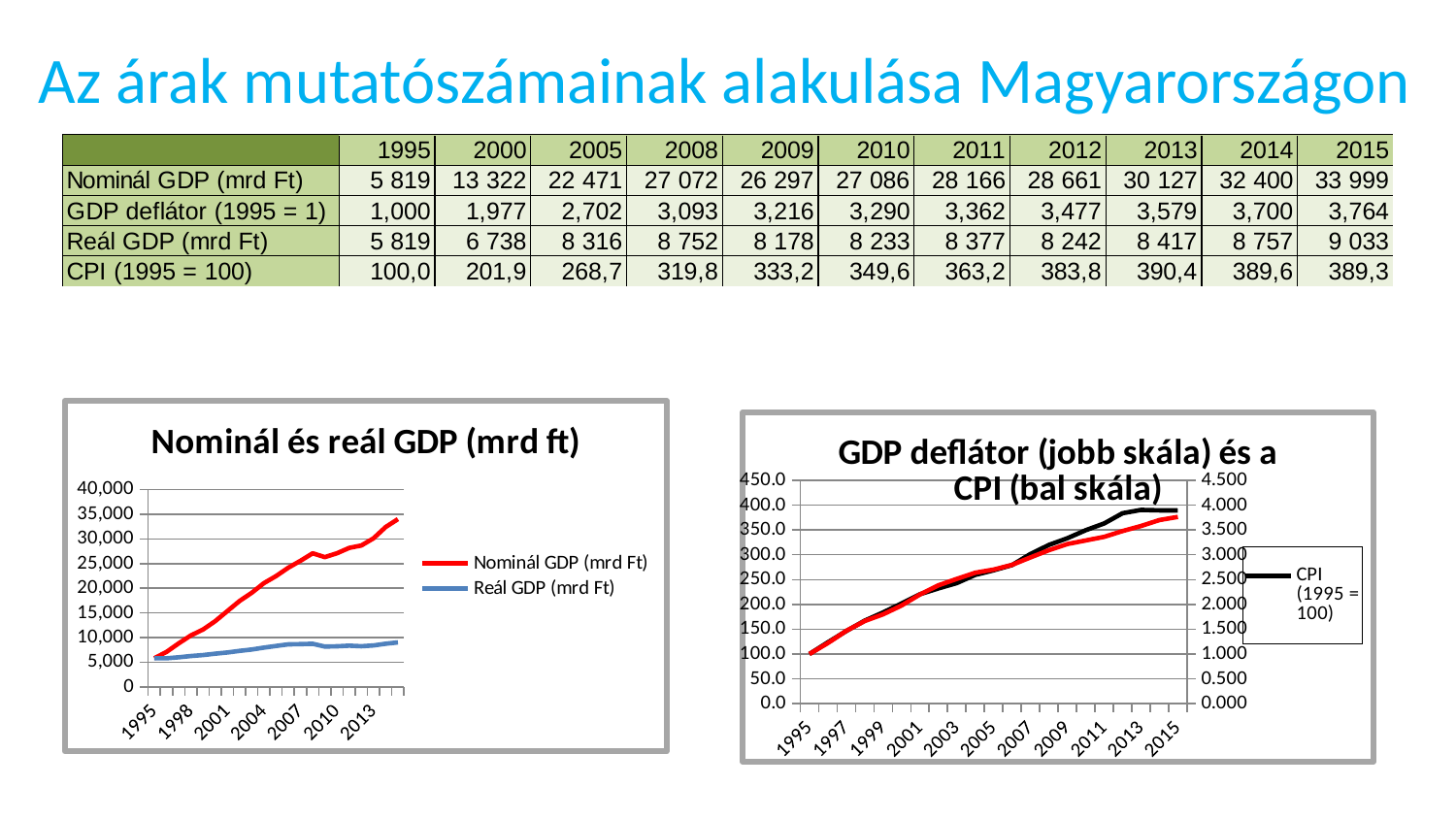
In the left chart "Nominál és reál GDP (mrd ft)", is the Reál GDP value at the end of the series (2015) greater or less than 10,000? less In the right chart "GDP deflátor (jobb skála) és a CPI (bal skála)", does the CPI line rise or fall overall from 1995 to 2015? rise In the right chart "GDP deflátor (jobb skála) és a CPI (bal skála)", is the CPI value in 2015 greater or less than 350.0 on the left scale? greater In the left chart "Nominál és reál GDP (mrd ft)", does the Nominál GDP line rise or fall from 1995 to 2015? rise How many series does the legend of the left chart "Nominál és reál GDP (mrd ft)" list? 2 In the left chart "Nominál és reál GDP (mrd ft)", which series is drawn in red? Nominál GDP (mrd Ft) In the left chart "Nominál és reál GDP (mrd ft)", is the Nominál GDP value at the end of the series (2015) greater or less than 30,000? greater What kind of chart is the right chart titled "GDP deflátor (jobb skála) és a CPI (bal skála)"? line chart What kind of chart is the left chart titled "Nominál és reál GDP (mrd ft)"? line chart How many year labels are shown on the x axis of the right chart "GDP deflátor (jobb skála) és a CPI (bal skála)"? 11 In the left chart "Nominál és reál GDP (mrd ft)", which series is higher in 2013: Nominál GDP or Reál GDP? Nominál GDP